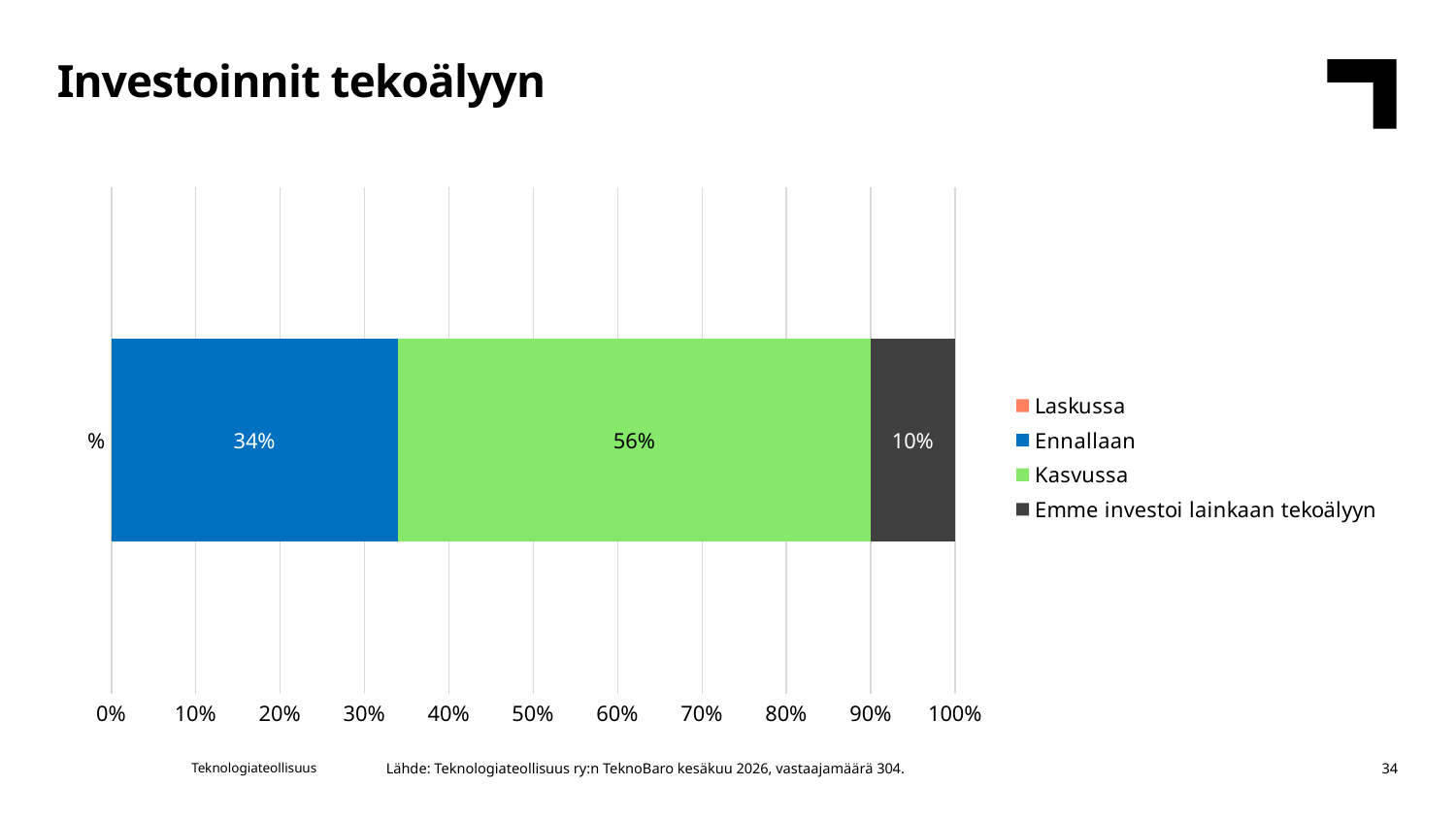
What is the difference between the Kasvussa and Ennallaan values? 22% What kind of chart is shown on the slide? bar chart What is the value for Ennallaan? 34% What is the total of the labelled segments in the stacked bar? 100% Which series has the largest segment in the bar? Kasvussa How many series does the legend list? 4 Which of the visible segments is the smallest? Emme investoi lainkaan tekoälyyn What colour is the Kasvussa segment? green What is the value for Kasvussa? 56% Which is larger, the value for Ennallaan or the value for Emme investoi lainkaan tekoälyyn? Ennallaan What is the title of the slide? Investoinnit tekoälyyn What is the value for Emme investoi lainkaan tekoälyyn? 10%